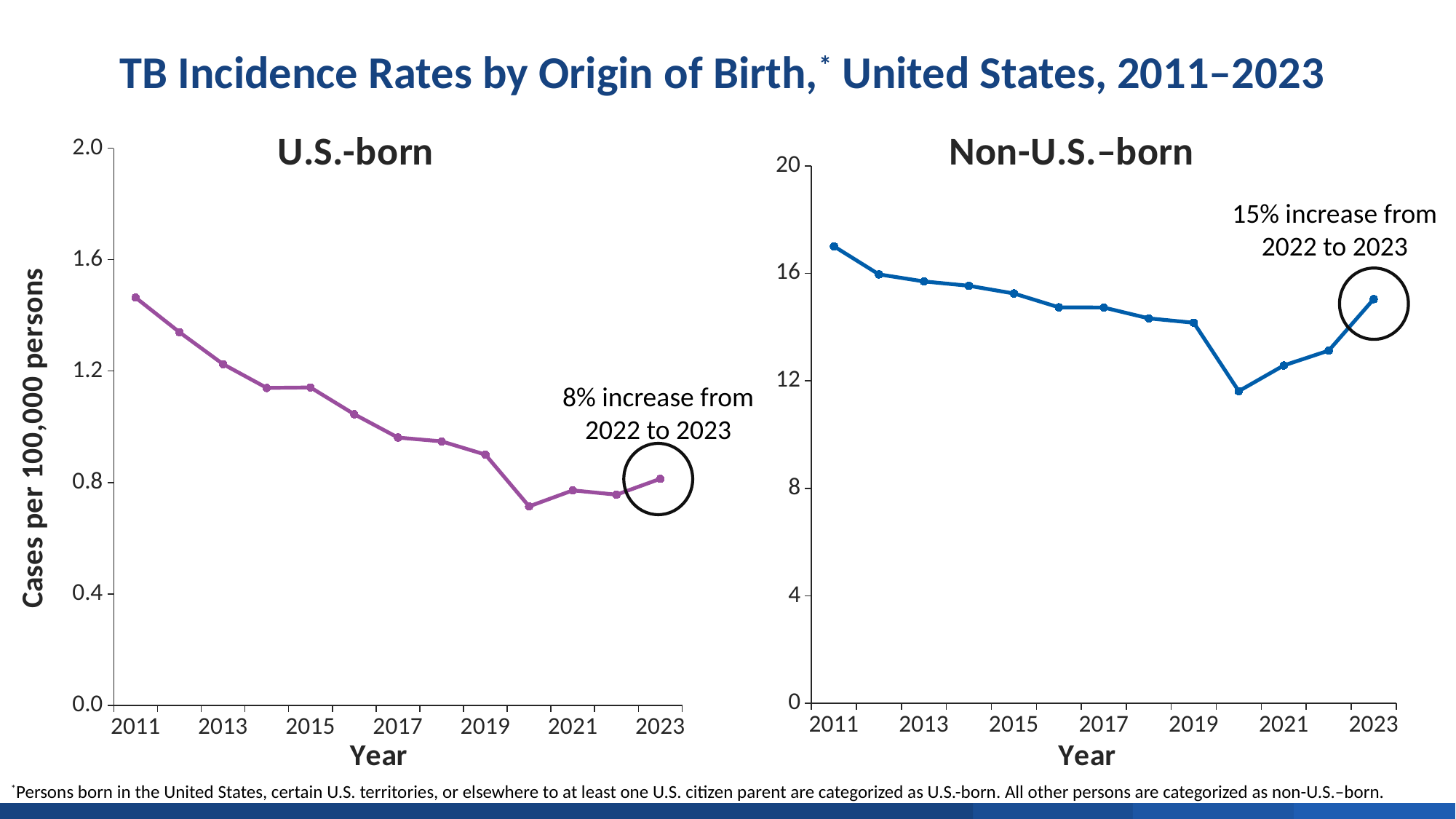
In the U.S.-born chart, is the value for 2020 greater or less than 0.8? less In the Non-U.S.-born chart, is the value for 2020 greater or less than 12? less In the Non-U.S.-born chart, is the value for 2011 greater or less than 16? greater What kind of chart is the U.S.-born chart? line chart How many data points are plotted in the U.S.-born chart? 13 In the Non-U.S.-born chart, which year has the larger value, 2019 or 2020? 2019 In the U.S.-born chart, which year has the lowest TB incidence rate? 2020 In the Non-U.S.-born chart, which year has the highest TB incidence rate? 2011 In the Non-U.S.-born chart, which year has the lowest TB incidence rate? 2020 In the U.S.-born chart, which year has the highest TB incidence rate? 2011 According to the annotation on the Non-U.S.-born chart, what was the percentage increase from 2022 to 2023? 15%